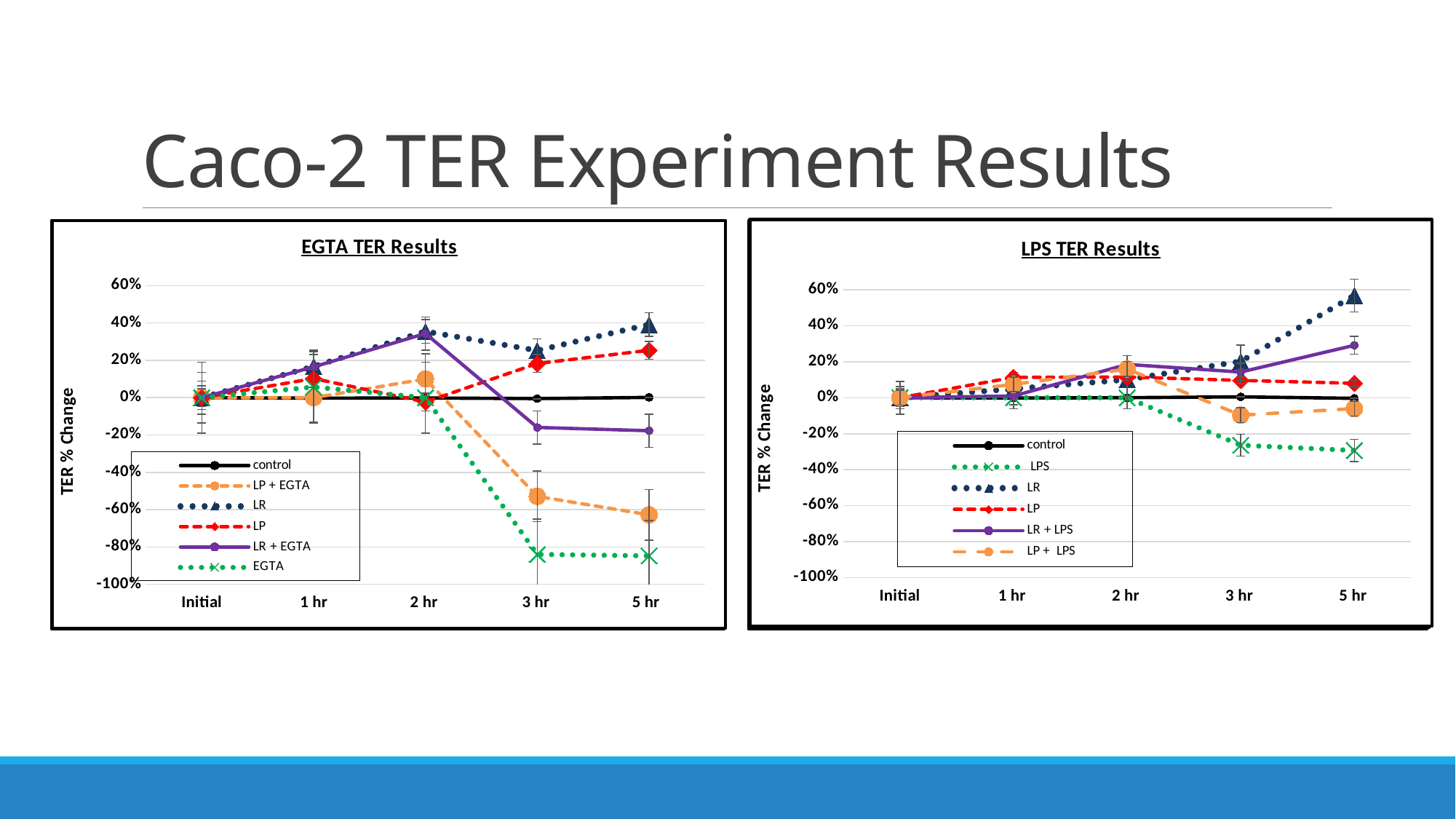
How many series does the legend of the EGTA TER Results chart list? 6 What kind of chart is the EGTA TER Results chart? line chart In the LPS TER Results chart, is the value for LR at 5 hr greater or less than 40%? greater How many time points are shown on the x axis of the LPS TER Results chart? 5 In the EGTA TER Results chart, which series has the highest value at 5 hr? LR In the LPS TER Results chart, does the LR series rise or fall from Initial to 5 hr? rise In the EGTA TER Results chart, which series has the lowest value at 5 hr? EGTA In the EGTA TER Results chart, is the value for LP + EGTA at 5 hr greater or less than -40%? less In the EGTA TER Results chart, is the value for LR at 5 hr greater or less than 20%? greater In the LPS TER Results chart, which series has the highest value at 5 hr? LR In the LPS TER Results chart, which series has the lowest value at 5 hr? LPS What is the y-axis label of the LPS TER Results chart? TER % Change